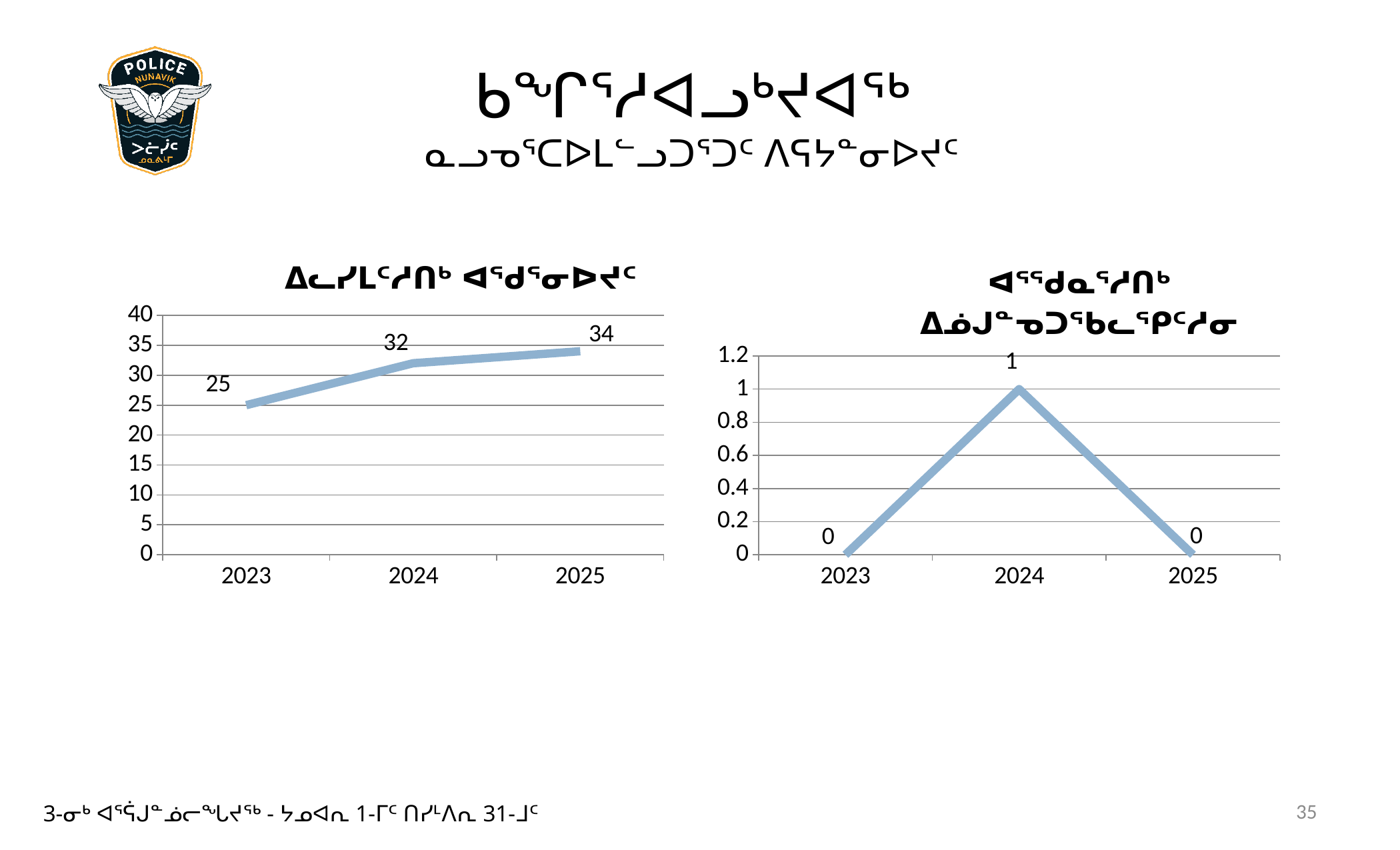
On the left chart, which year has the lowest value? 2023 On the left chart, do the values rise or fall from 2023 to 2025? rise On the left chart, is the value for 2024 larger or smaller than the value for 2023? larger On the right chart, which year has the highest value? 2024 On the left chart, what is the difference between the values for 2025 and 2023? 9 On the left chart, what is the value for 2023? 25 What kind of chart is the left chart? line chart On the left chart, what is the value for 2025? 34 On the left chart, how many years are plotted? 3 On the right chart, what is the value for 2025? 0 On the right chart, what is the value for 2024? 1 On the left chart, which year has the highest value? 2025